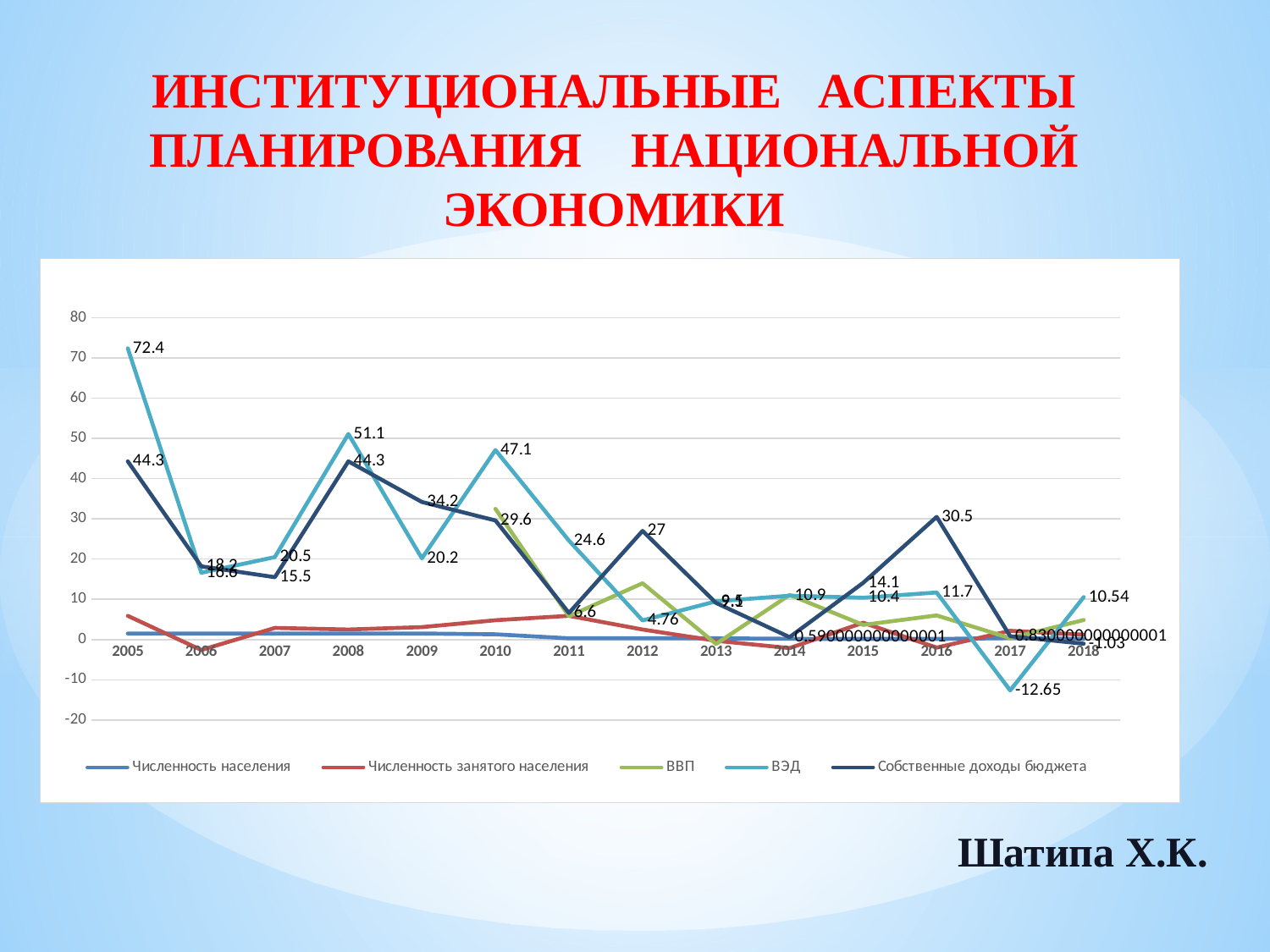
What is the value of ВЭД in 2005? 72.4 In 2012, which is larger: ВЭД or Собственные доходы бюджета? Собственные доходы бюджета What is the value of ВЭД in 2018? 10.54 What kind of chart is shown on the slide? line chart What is the difference between the ВЭД values in 2008 and 2009? 30.9 Is the value for Численность населения in 2005 greater or less than 10? less How many years are shown on the x axis? 14 In which year is ВЭД at its highest? 2005 What is the value of Собственные доходы бюджета in 2016? 30.5 In which year is ВЭД at its lowest? 2017 What is the value of ВЭД in 2017? -12.65 How many series does the legend list? 5